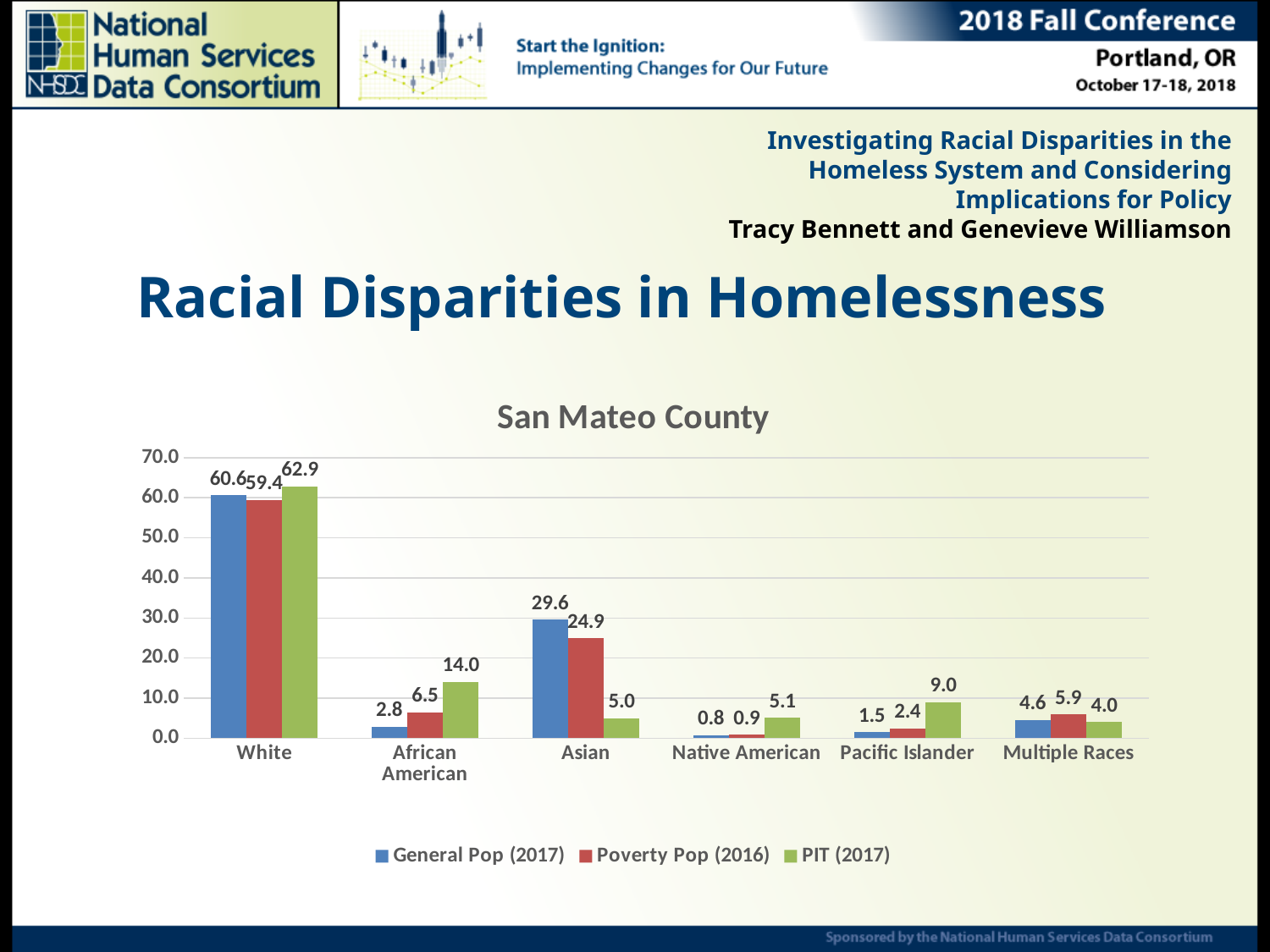
What is the General Pop (2017) value for Asian? 29.6 What is the Poverty Pop (2016) value for Pacific Islander? 2.4 What is the chart's title? San Mateo County Which category has the highest PIT (2017) value? White How many series does the legend list? 3 Which series is shown in green in the legend? PIT (2017) What is the difference between the General Pop (2017) and PIT (2017) values for Asian? 24.6 Which category has the lowest General Pop (2017) value? Native American What type of chart is shown on the slide? bar chart Which is larger for Multiple Races: the Poverty Pop (2016) value or the PIT (2017) value? Poverty Pop (2016) How many racial categories are shown on the x axis? 6 What is the PIT (2017) value for African American? 14.0